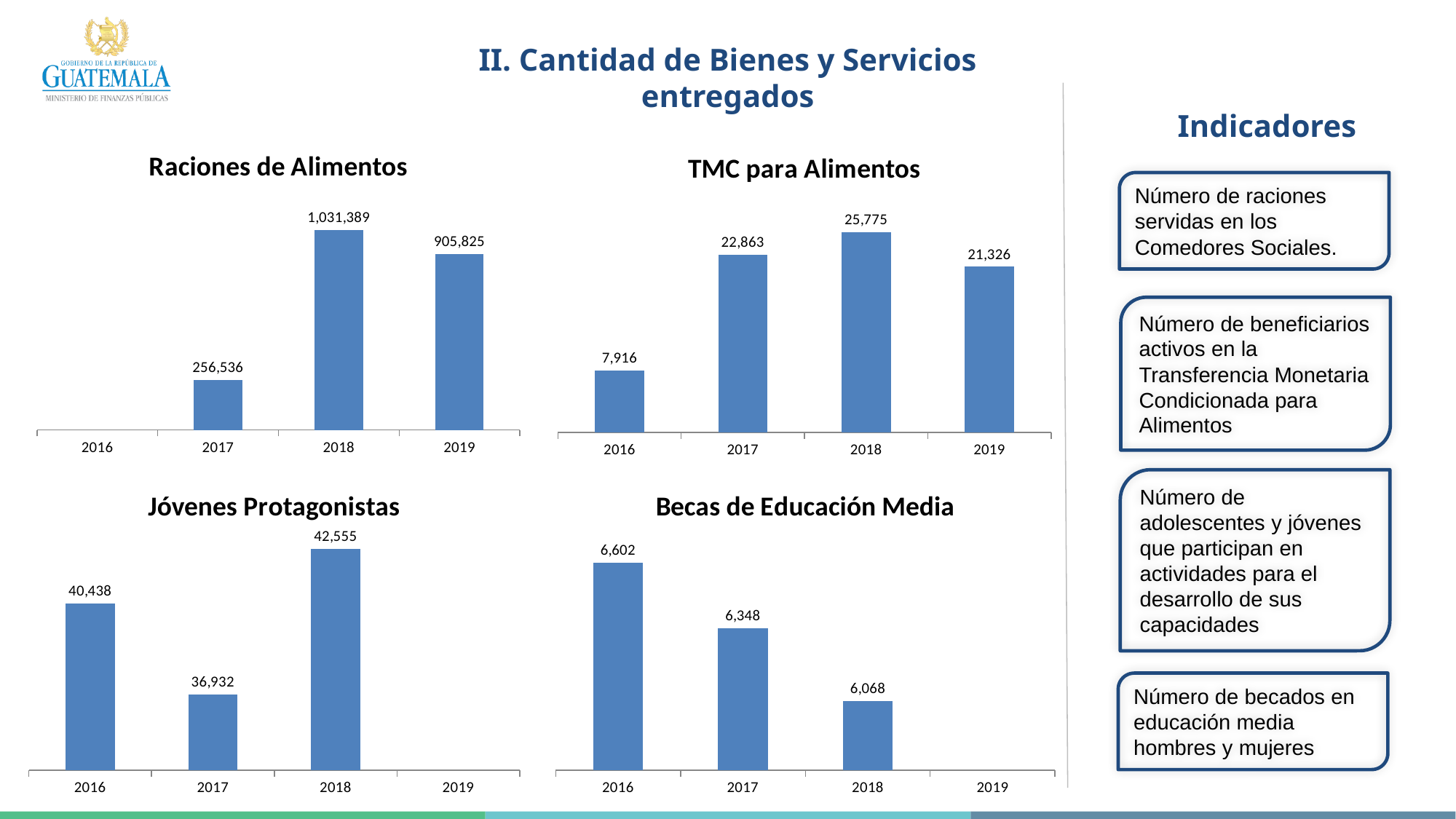
In the 'Raciones de Alimentos' chart, which year has the highest value? 2018 In the 'TMC para Alimentos' chart, what is the value for 2016? 7,916 In the 'Raciones de Alimentos' chart, what is the difference between the 2018 and 2019 values? 125,564 In the 'Becas de Educación Media' chart, what is the value for 2019 shown as a bar? No bar is shown for 2019 In the 'Raciones de Alimentos' chart, what is the value for 2018? 1,031,389 In the 'TMC para Alimentos' chart, which year has the lowest value? 2016 In the 'Jóvenes Protagonistas' chart, what is the value for 2017? 36,932 In the 'Jóvenes Protagonistas' chart, which is larger, the value for 2016 or the value for 2018? 2018 In the 'Becas de Educación Media' chart, what is the difference between the 2016 and 2018 values? 534 In the 'Becas de Educación Media' chart, do the values rise or fall from 2016 to 2018? fall In the 'TMC para Alimentos' chart, what is the difference between the 2018 and 2016 values? 17,859 What kind of chart is 'Jóvenes Protagonistas'? bar chart